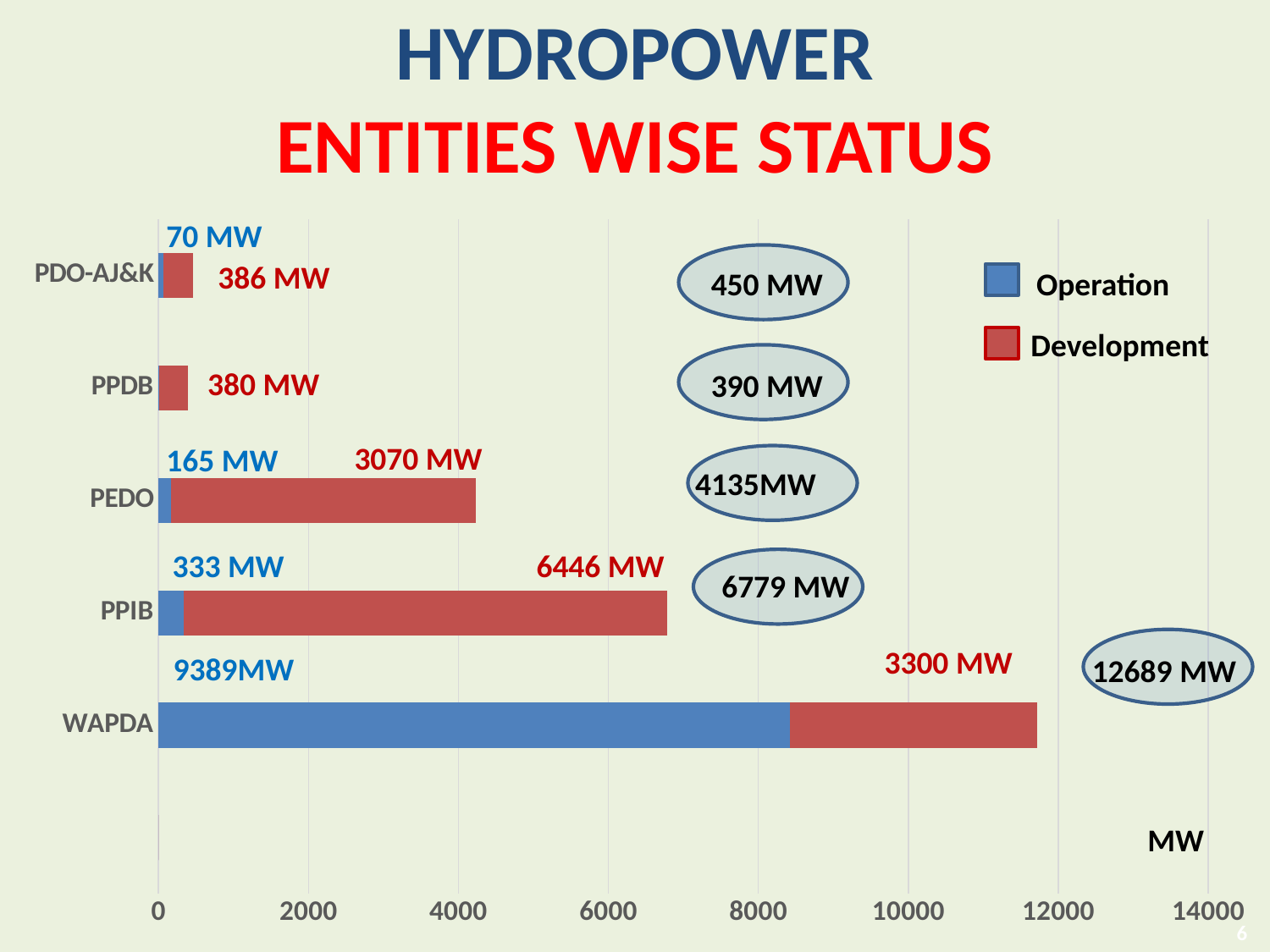
Which entity has the highest Development value? PPIB Is the total bar length for WAPDA greater or less than 12000? less How many entities are shown on the chart? 5 What is the Operation value for PEDO? 165 MW What is the Development value for PDO-AJ&K? 386 MW What total is shown in the oval for PPIB? 6779 MW Which is larger, the Development value for PEDO or the Development value for WAPDA? WAPDA How many series does the legend list? 2 Which entity has the lowest Operation value among those with a printed Operation label? PDO-AJ&K What is the Development value for PPIB? 6446 MW What is the difference between the Operation values of WAPDA and PPIB? 9056 MW What is the Operation value for WAPDA? 9389MW